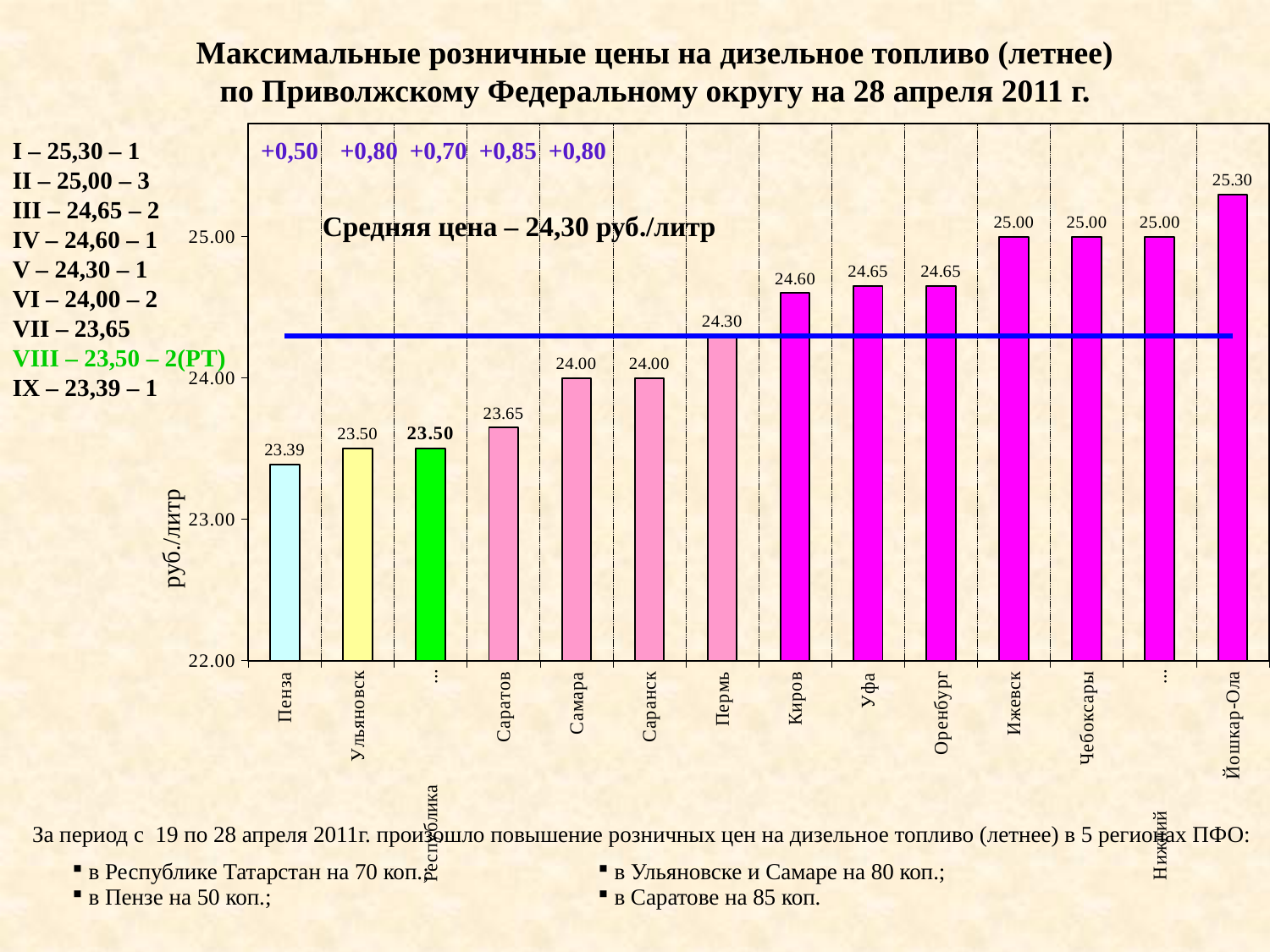
What is the value for Пермь? 24.30 What is the difference between the values for Уфа and Саратов? 1.00 What is the value for Пенза? 23.39 What is the difference between the values for Йошкар-Ола and Пенза? 1.91 What is the value for Киров? 24.60 Which category has the highest value? Йошкар-Ола What kind of chart is shown on the slide? bar chart Which category has the lowest value? Пенза Is the value for Самара greater or less than 25.00? less What is the value for Йошкар-Ола? 25.30 How many bars are shown in the chart? 14 Which is larger, the value for Ижевск or the value for Оренбург? Ижевск